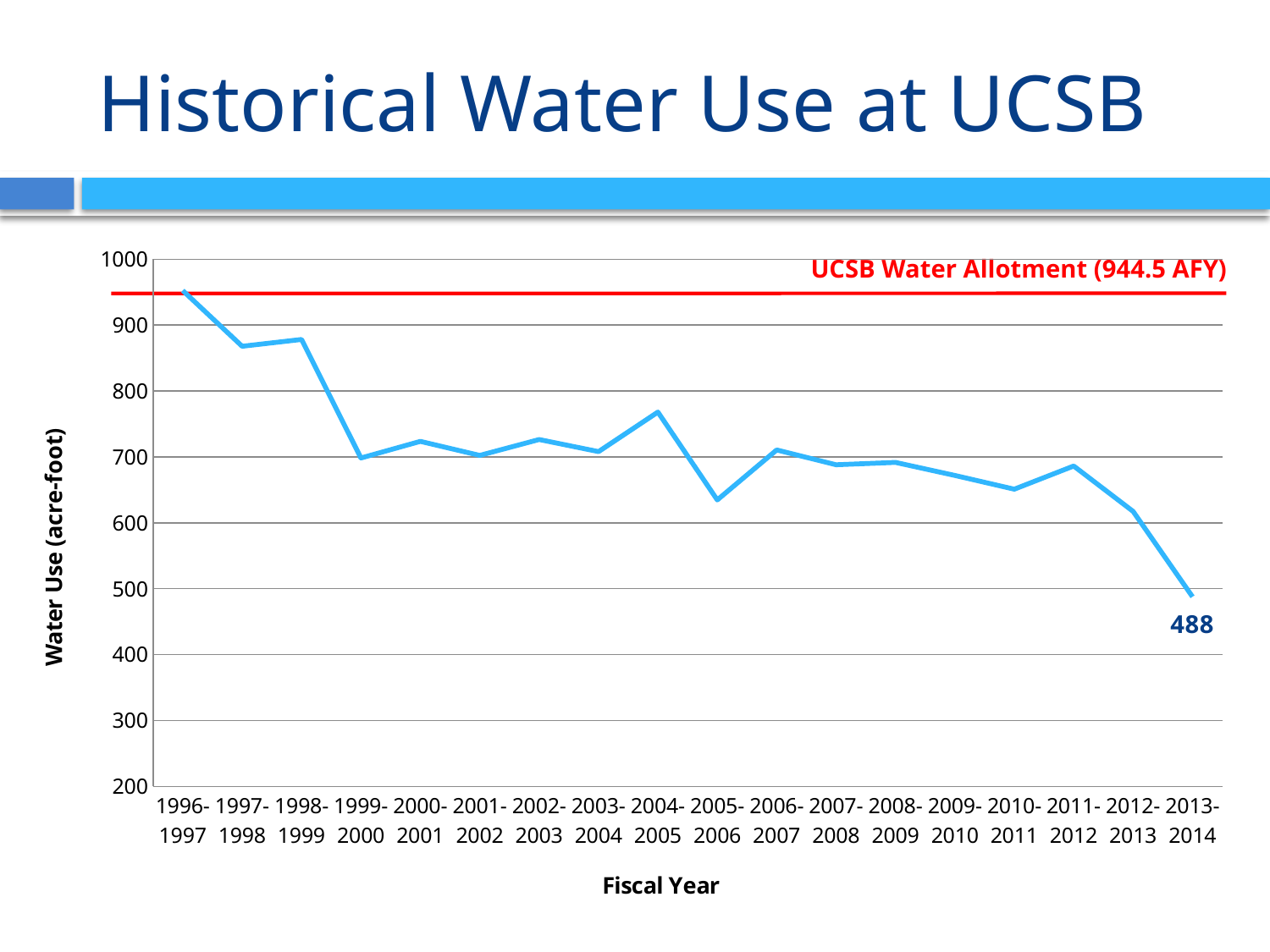
What is the water use value for fiscal year 2013-2014? 488 Overall, does water use rise or fall from 1996-1997 to 2013-2014? fall Is the water use for fiscal year 1996-1997 greater or less than 900? greater What value is given for the UCSB Water Allotment shown by the red line? 944.5 AFY What is the label of the y axis? Water Use (acre-foot) How many fiscal years are plotted on the x axis? 18 Is the water use for fiscal year 2004-2005 greater or less than 800? less Which fiscal year has the highest water use? 1996-1997 What kind of chart is shown on the slide? line chart Which fiscal year has higher water use, 2004-2005 or 2005-2006? 2004-2005 Is the water use for fiscal year 2005-2006 greater or less than 700? less Which fiscal year has the lowest water use? 2013-2014